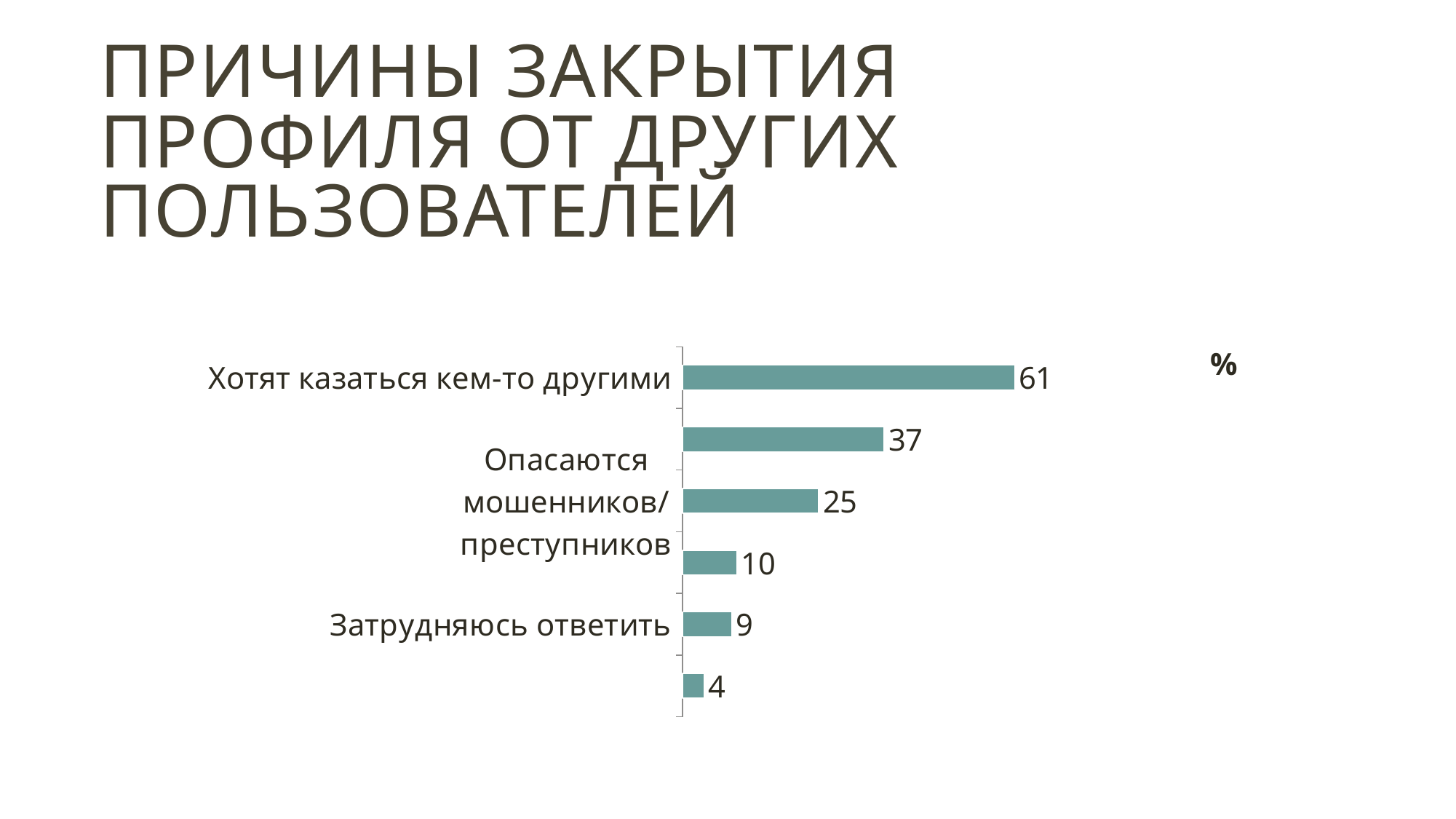
What is the value for "Опасаются мошенников/преступников"? 25 What is the difference between the values for "Хотят казаться кем-то другими" and "Опасаются мошенников/преступников"? 36 Which category has the highest value? Хотят казаться кем-то другими What is the value for "Затрудняюсь ответить"? 9 How many bars are plotted on the chart? 6 What is the value for "Хотят казаться кем-то другими"? 61 What unit symbol is shown next to the chart? % Which is larger: the value for "Опасаются мошенников/преступников" or the value for "Затрудняюсь ответить"? Опасаются мошенников/преступников What kind of chart is shown on the slide? Bar chart What is the value of the shortest bar on the chart? 4 What is the difference between the values for "Опасаются мошенников/преступников" and "Затрудняюсь ответить"? 16 What is the value of the longest bar on the chart? 61